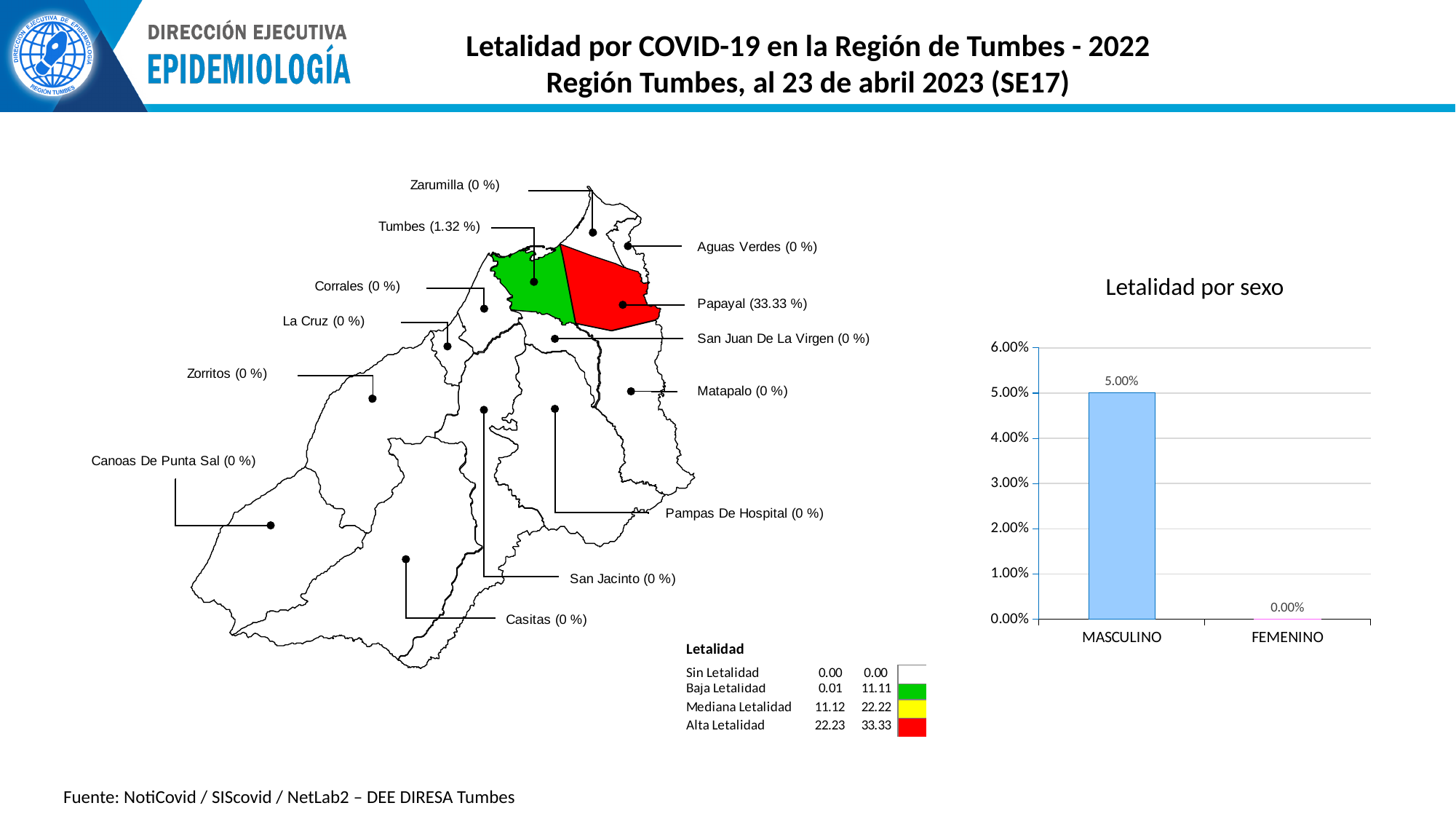
In the 'Letalidad por sexo' chart, what is the difference between the MASCULINO and FEMENINO values? 5.00% What kind of chart is 'Letalidad por sexo'? bar chart In the 'Letalidad por sexo' chart, what is the value for FEMENINO? 0.00% How many categories are shown on the x axis of the 'Letalidad por sexo' chart? 2 On the map on the left, which district has the highest lethality value? Papayal In the 'Letalidad por sexo' chart, what is the value for MASCULINO? 5.00% In the 'Letalidad por sexo' chart, which category has the highest value? MASCULINO In the 'Letalidad por sexo' chart, is the value for MASCULINO greater or less than 4.00%? greater On the map on the left, what is the lethality value shown for Papayal? 33.33 % On the map on the left, what is the lethality value shown for Tumbes? 1.32 % In the 'Letalidad por sexo' chart, which category has the lowest value? FEMENINO What is the highest value shown on the y axis of the 'Letalidad por sexo' chart? 6.00%